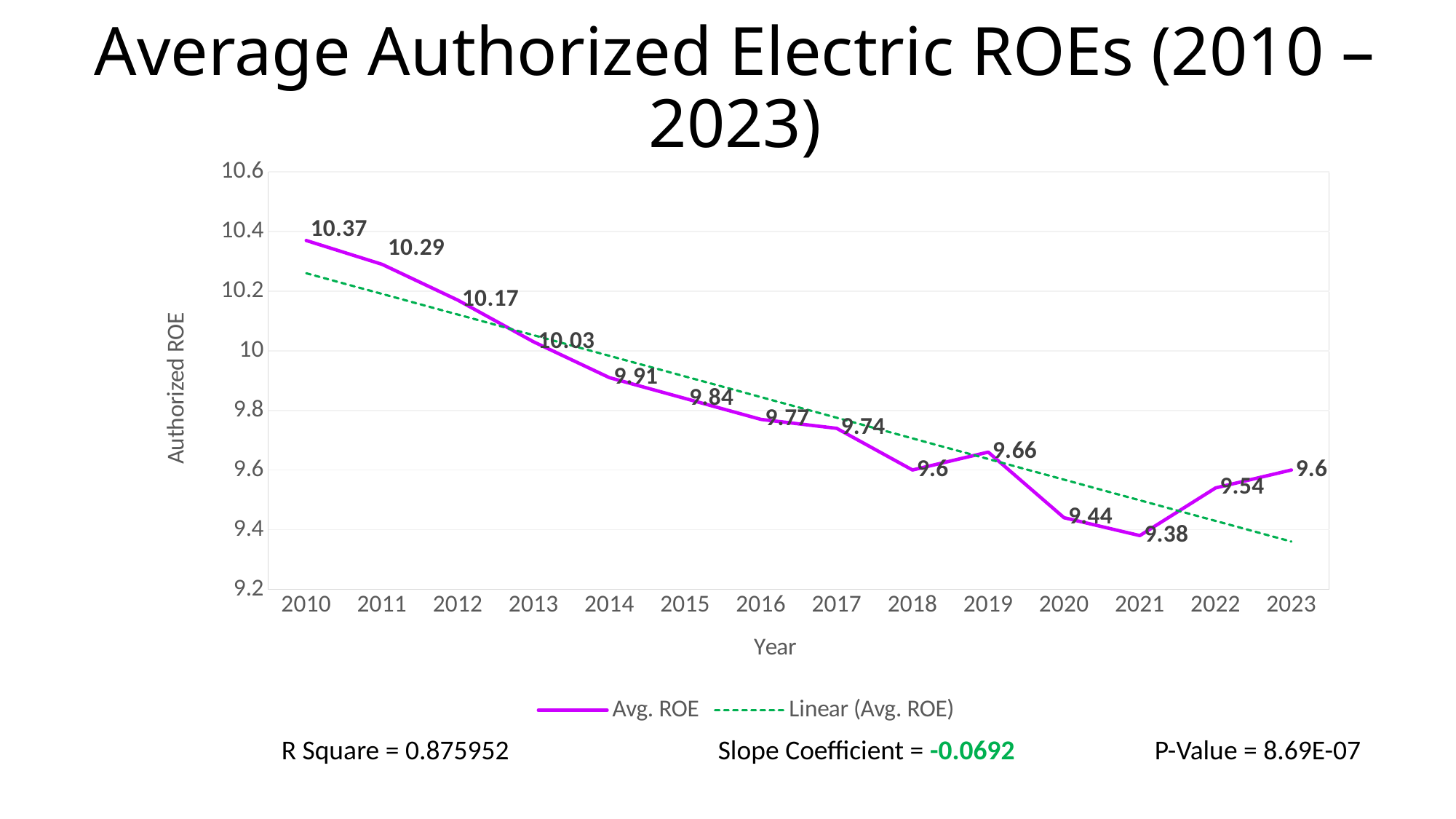
What is the overall trend of the average authorized ROE from 2010 to 2023? falling What is the average authorized ROE for 2010? 10.37 What is the average authorized ROE for 2017? 9.74 Which year has the lowest average authorized ROE? 2021 How many series does the legend list? 2 How many years are plotted on the x axis? 14 What is the average authorized ROE for 2021? 9.38 Which year has a higher average authorized ROE, 2019 or 2020? 2019 What kind of chart is shown on the slide? line chart What is the difference between the average authorized ROE in 2010 and in 2023? 0.77 Which year has the highest average authorized ROE? 2010 Is the value for 2014 greater or less than 10? less